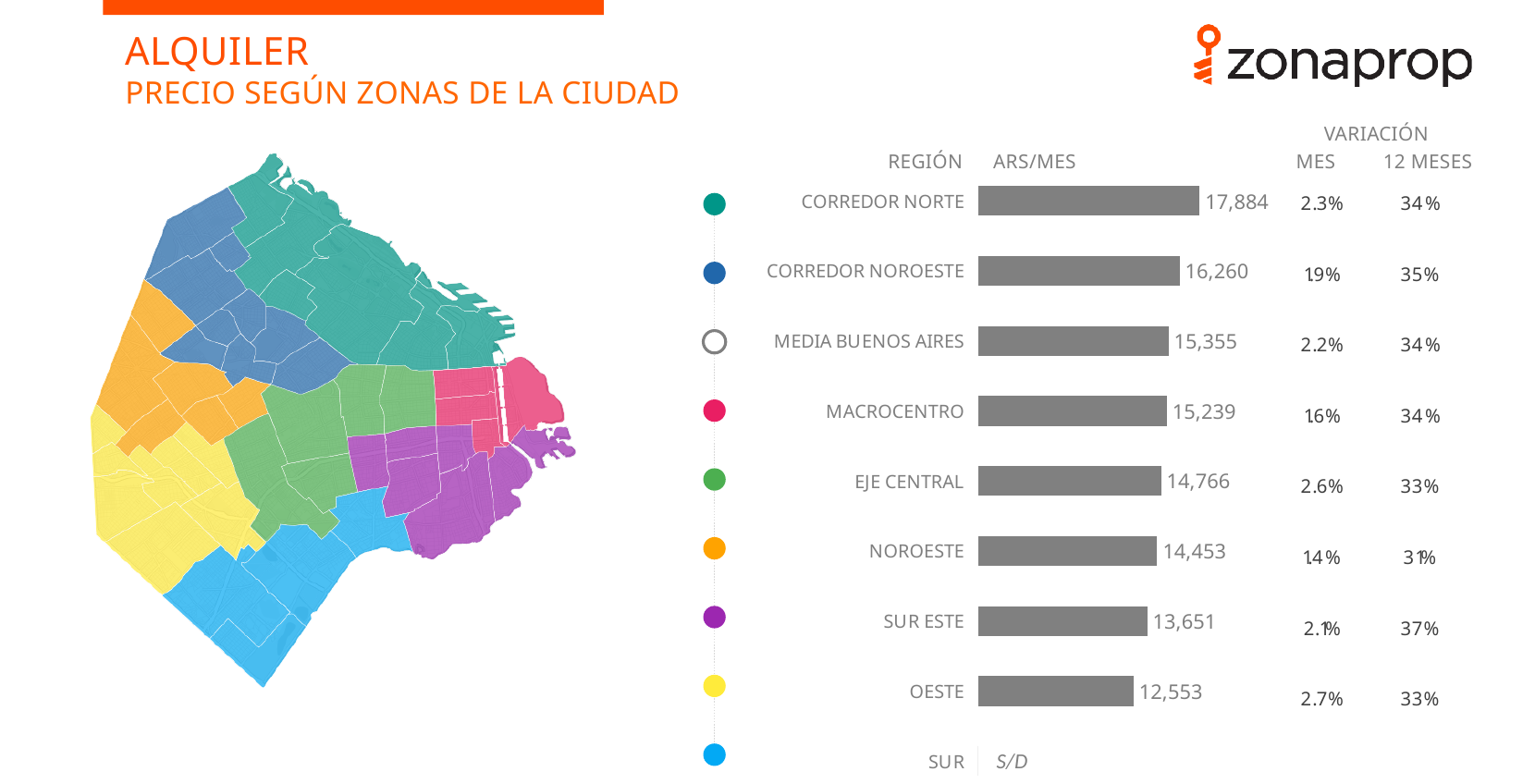
What kind of chart is used to show the ARS/MES values? Bar chart What is the ARS/MES value for OESTE? 12,553 How many regions have an ARS/MES bar plotted? 8 Which has a higher ARS/MES value, SUR ESTE or NOROESTE? NOROESTE Which region has the highest ARS/MES value? CORREDOR NORTE What is the 12-month variation (VARIACIÓN 12 MESES) for SUR ESTE? 37% What is the difference in ARS/MES between CORREDOR NOROESTE and MEDIA BUENOS AIRES? 905 What is the ARS/MES value for CORREDOR NORTE? 17,884 What is the ARS/MES value for EJE CENTRAL? 14,766 What is the difference in ARS/MES between CORREDOR NORTE and OESTE? 5,331 Which region with a plotted bar has the lowest ARS/MES value? OESTE What value is shown for the SUR region's ARS/MES? S/D